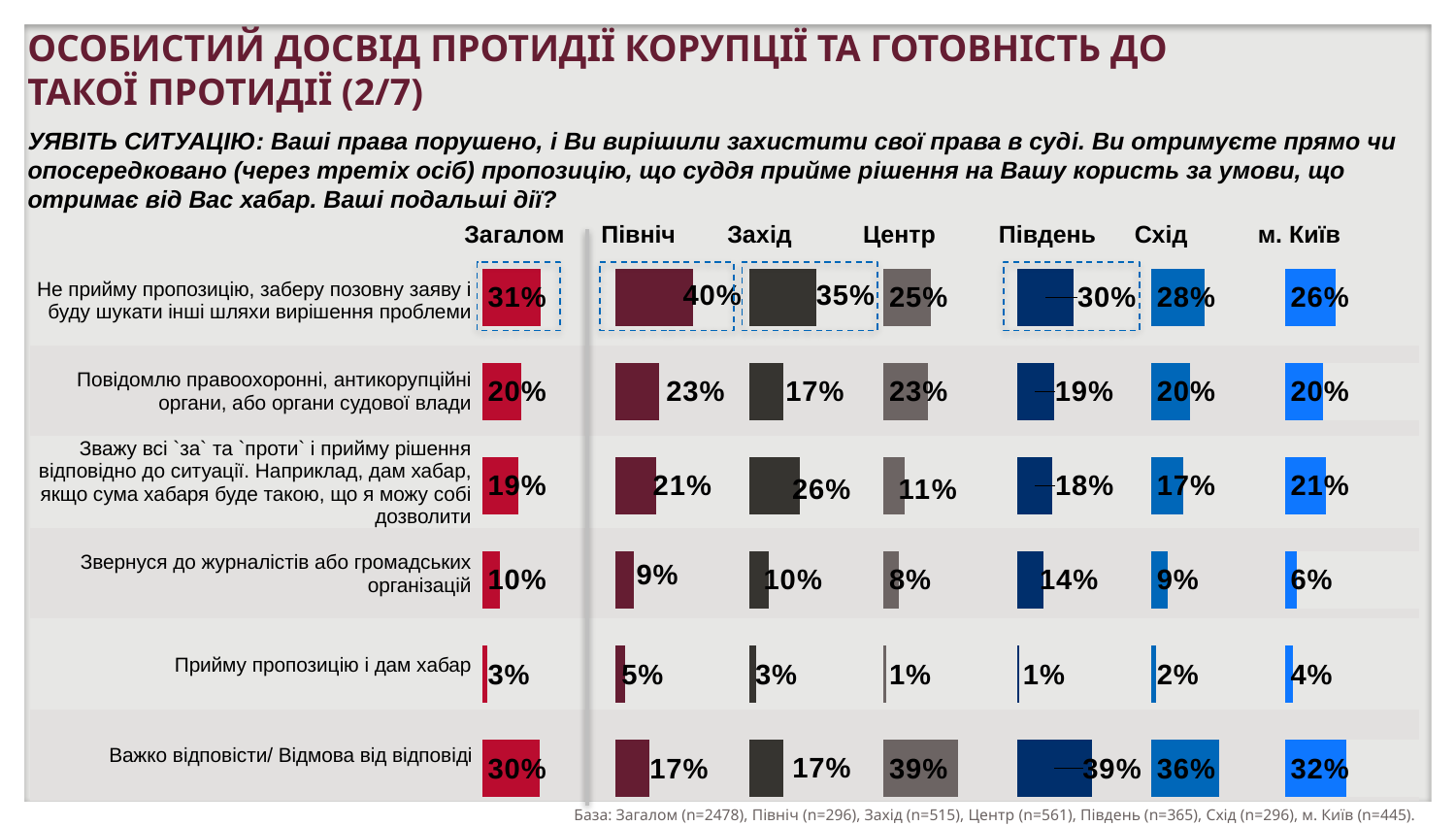
What is the value for "Південь" for "Звернуся до журналістів або громадських організацій"? 14% Which is larger for "Повідомлю правоохоронні, антикорупційні органи, або органи судової влади": the value for "Північ" or the value for "Захід"? Північ How many response options are listed in the chart? 6 Which region has the lowest value for "Звернуся до журналістів або громадських організацій"? м. Київ What percentage of respondents in "Центр" chose "Важко відповісти/ Відмова від відповіді"? 39% What type of chart is used on the slide? Bar chart What is the value for "Загалом" for the response "Не прийму пропозицію, заберу позовну заяву і буду шукати інші шляхи вирішення проблеми"? 31% What is the value for "м. Київ" for "Прийму пропозицію і дам хабар"? 4% Which region has the highest value for "Не прийму пропозицію, заберу позовну заяву і буду шукати інші шляхи вирішення проблеми"? Північ How many regional columns (including "Загалом") are shown in the chart? 7 What is the difference between "Захід" and "Центр" for "Зважу всі `за` та `проти` і прийму рішення відповідно до ситуації"? 15% What is the sample size (n) for "Загалом" given in the base note? 2478